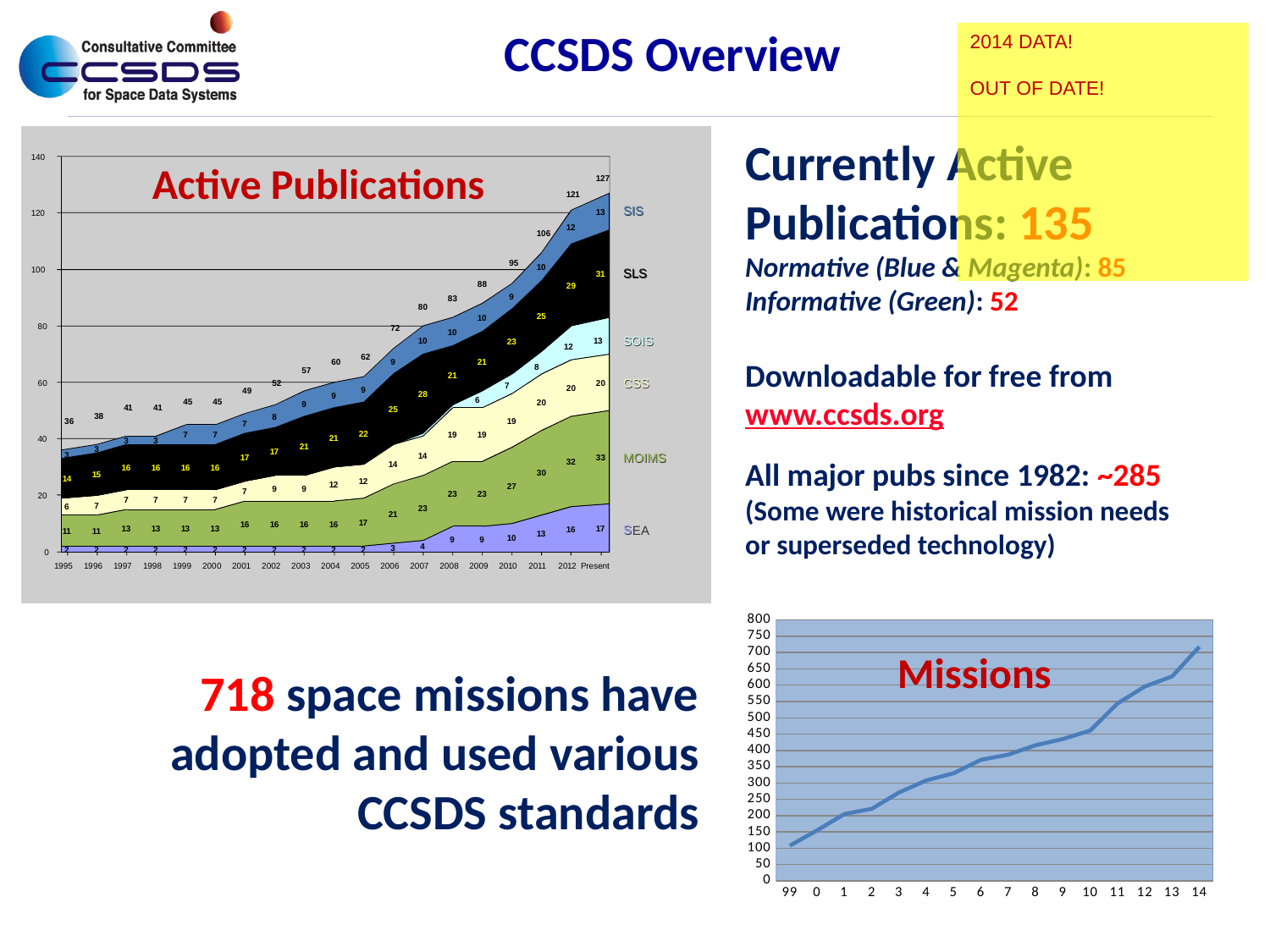
In the Active Publications chart, which year has the lowest total of active publications? 1995 In the Active Publications chart, how many series are shown in the legend? 6 In the Active Publications chart, what is the total number of active publications in 2012? 121 In the Active Publications chart, what is the total number of active publications at Present? 127 In the Active Publications chart, do the total active publications rise or fall from 1995 to Present? rise In the Active Publications chart, which is larger at Present: the SLS value or the MOIMS value? MOIMS In the Active Publications chart, what is the SEA value for 2008? 9 What kind of chart is the Missions chart? line chart In the Missions chart, is the value for 14 greater or less than 650? greater In the Active Publications chart, what is the difference between the total for 2012 and the total for 2011? 15 In the Missions chart, is the value for 99 greater or less than 150? less In the Active Publications chart, what is the MOIMS value for 2011? 30